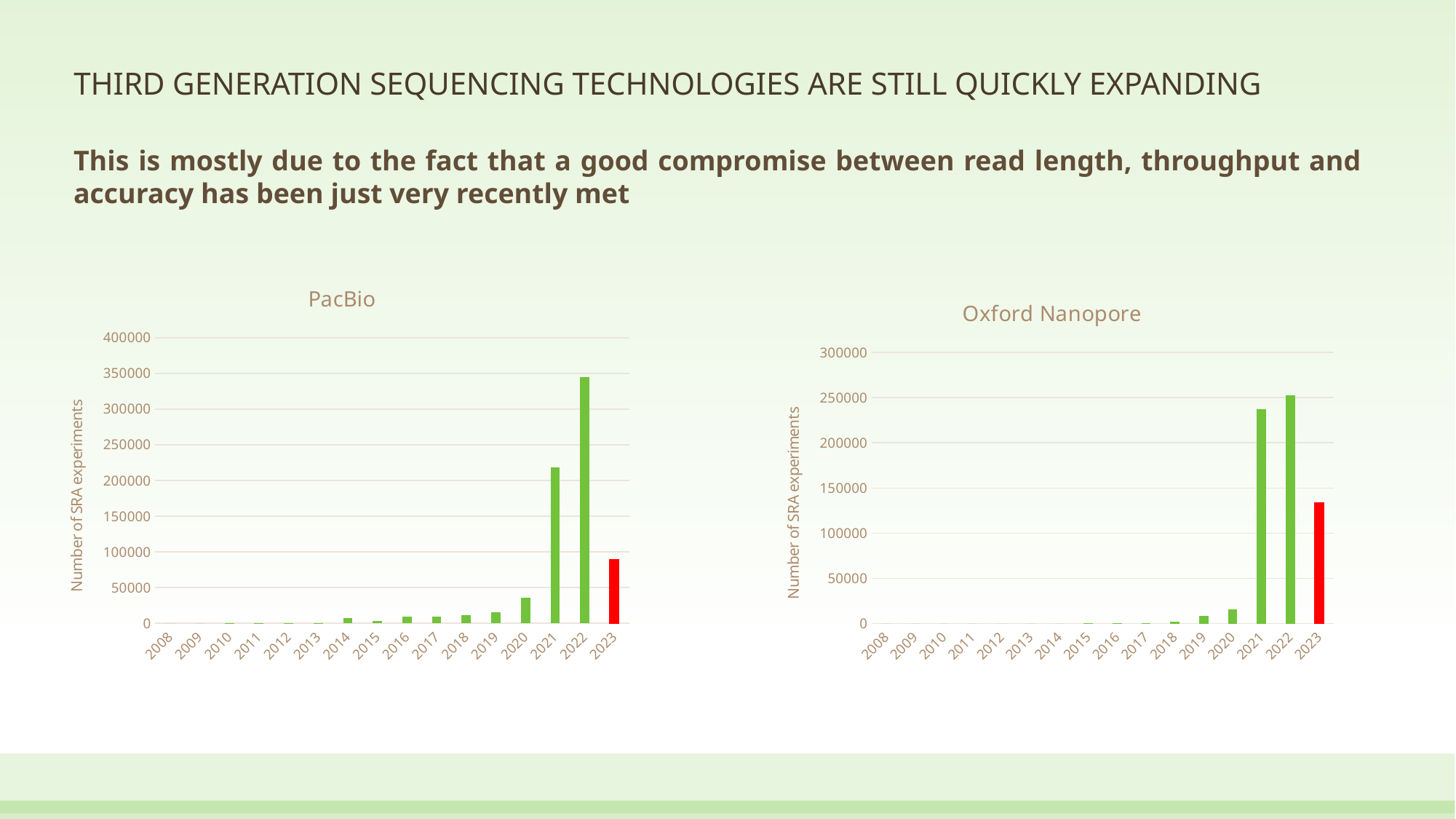
In the Oxford Nanopore chart, which is larger, the value for 2021 or the value for 2023? 2021 In the PacBio chart, is the value for 2023 greater or less than 100000? less In the PacBio chart, is the value for 2022 greater or less than 300000? greater In the PacBio chart, which is larger, the value for 2020 or the value for 2021? 2021 How many years are shown on the x axis of the Oxford Nanopore chart? 16 What kind of chart is the PacBio chart? bar chart In the PacBio chart, is the value for 2021 greater or less than 200000? greater What is the y-axis label of the Oxford Nanopore chart? Number of SRA experiments In the PacBio chart, which year's bar is coloured red? 2023 In the PacBio chart, which year has the highest number of SRA experiments? 2022